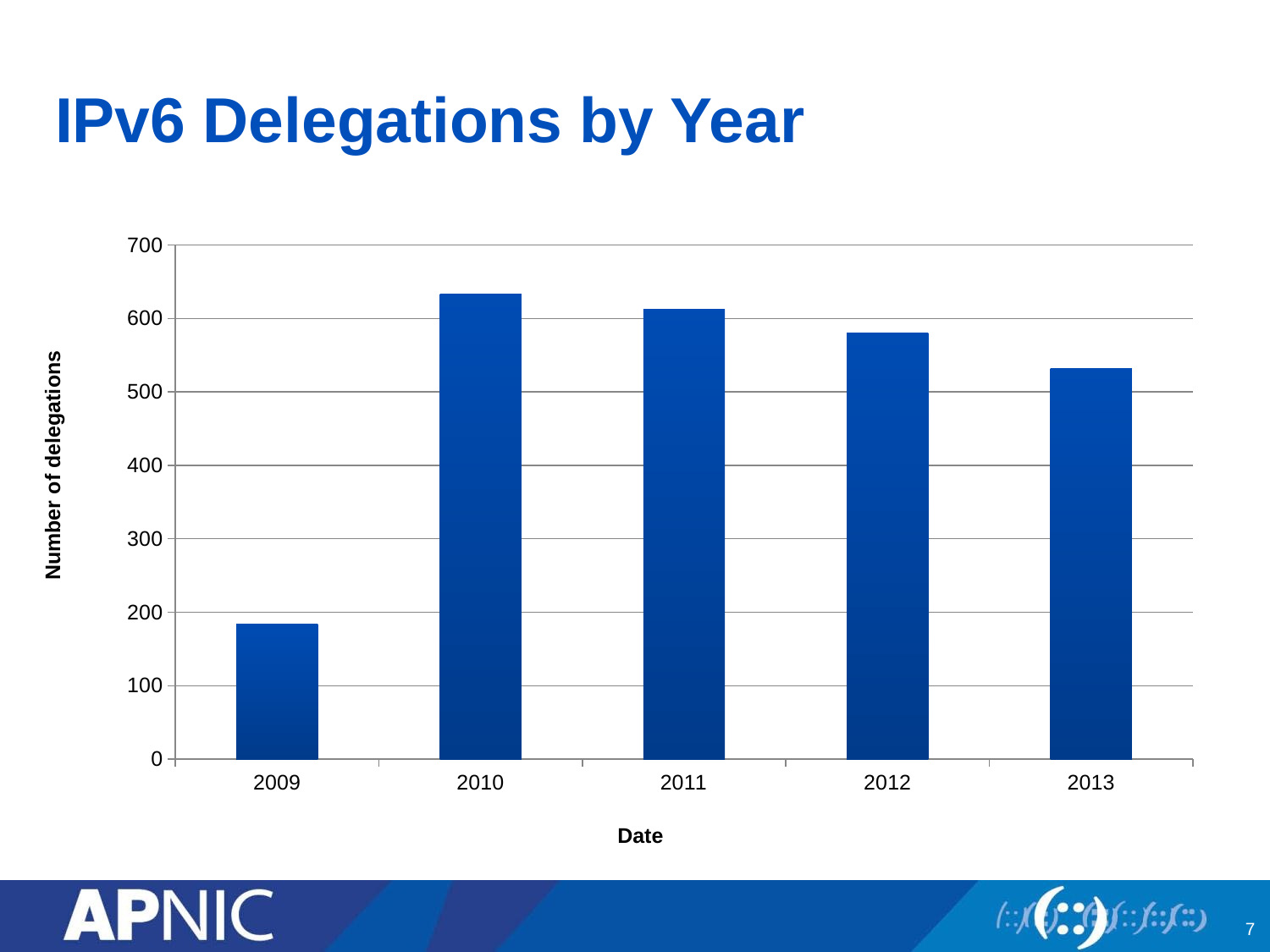
How many years are shown on the x axis of the chart? 5 Which year has more delegations, 2011 or 2013? 2011 Is the value for 2009 greater or less than 200? less Which year has the highest number of delegations? 2010 What kind of chart is shown on the slide? bar chart From 2010 to 2013, do the number of delegations rise or fall? fall Which year has more delegations, 2009 or 2013? 2013 Is the value for 2012 greater or less than 600? less Is the value for 2013 greater or less than 500? greater What is the label on the vertical axis of the chart? Number of delegations Which year has the lowest number of delegations? 2009